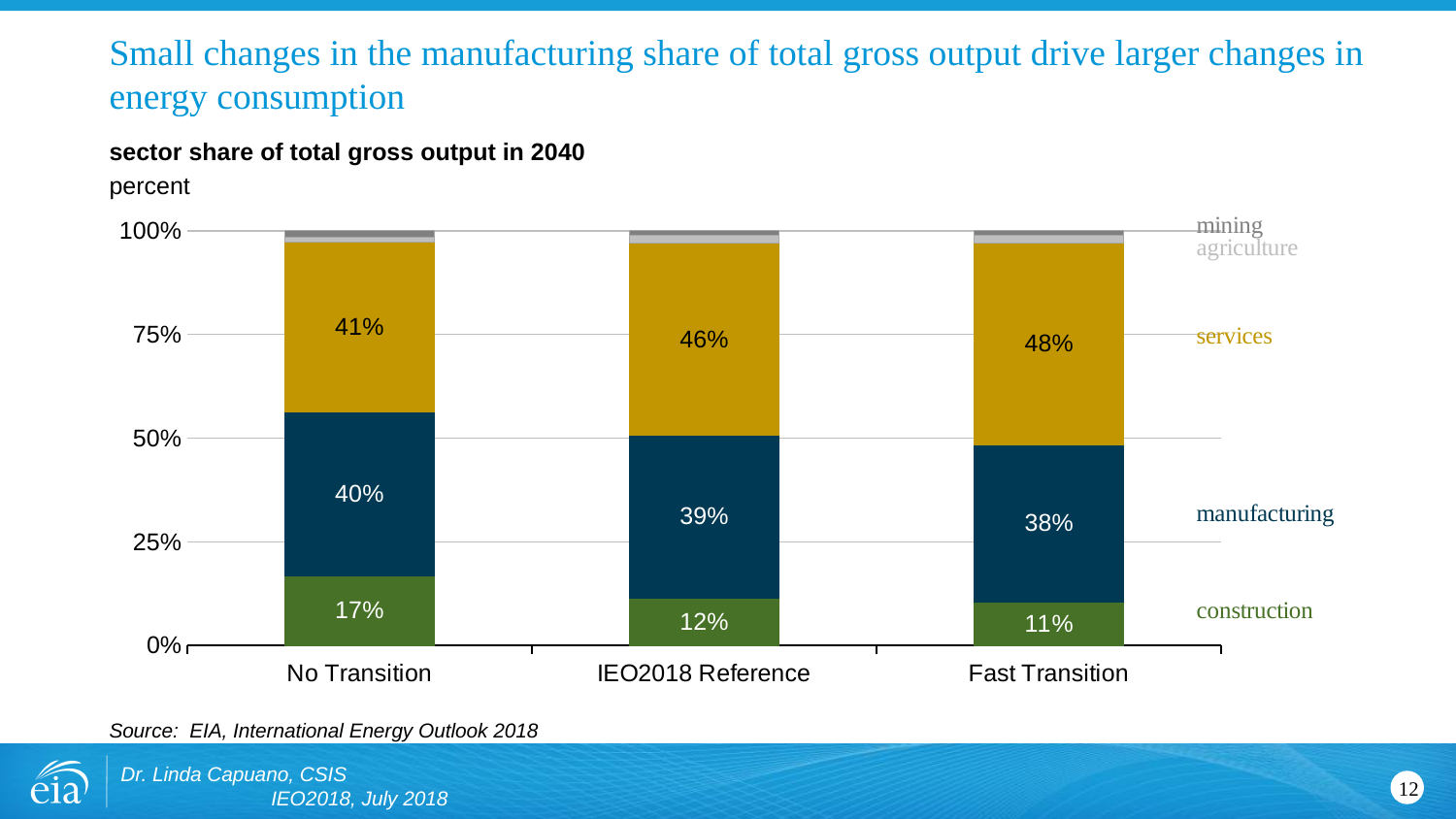
What is the construction share of total gross output in 2040 for the IEO2018 Reference case? 12% Which case has the highest services share of total gross output in 2040? Fast Transition Which case has the lowest construction share of total gross output in 2040? Fast Transition What is the difference between the services share in the Fast Transition case and the No Transition case? 7% How many sectors (series) does the chart show? 5 What kind of chart is shown on the slide? Stacked bar chart What is the manufacturing share of total gross output in 2040 for the Fast Transition case? 38% Which is larger: the manufacturing share in the No Transition case or in the IEO2018 Reference case? No Transition Which sector is shown in the dark blue segments of the bars? manufacturing How many cases (categories) are shown on the x axis? 3 What is the services share of total gross output in 2040 for the No Transition case? 41% Does the manufacturing share rise or fall moving from No Transition to Fast Transition? Fall